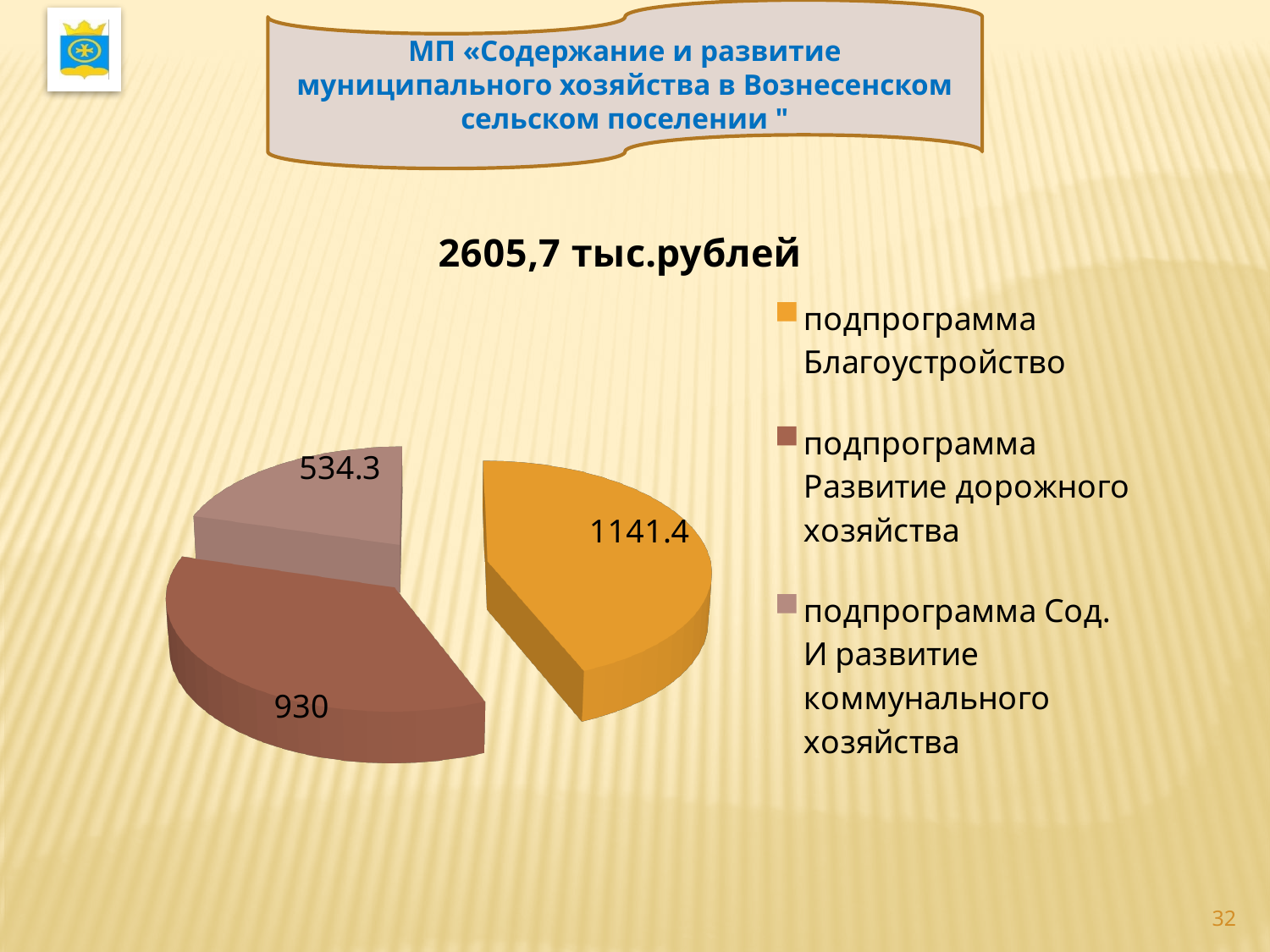
Which subprogram has the largest slice of the pie? подпрограмма Благоустройство What is the value for подпрограмма Сод. И развитие коммунального хозяйства? 534.3 How many slices does the pie chart have? 3 Which subprogram has the smallest slice of the pie? подпрограмма Сод. И развитие коммунального хозяйства Which is larger: the value for подпрограмма Развитие дорожного хозяйства or for подпрограмма Сод. И развитие коммунального хозяйства? подпрограмма Развитие дорожного хозяйства What colour is the slice for подпрограмма Благоустройство? orange What is the value for подпрограмма Развитие дорожного хозяйства? 930 What is the difference between the values for подпрограмма Благоустройство and подпрограмма Развитие дорожного хозяйства? 211.4 What is the difference between the values for подпрограмма Развитие дорожного хозяйства and подпрограмма Сод. И развитие коммунального хозяйства? 395.7 What is the value for подпрограмма Благоустройство? 1141.4 What is the title of the pie chart? 2605,7 тыс.рублей What kind of chart is shown on the slide? pie chart